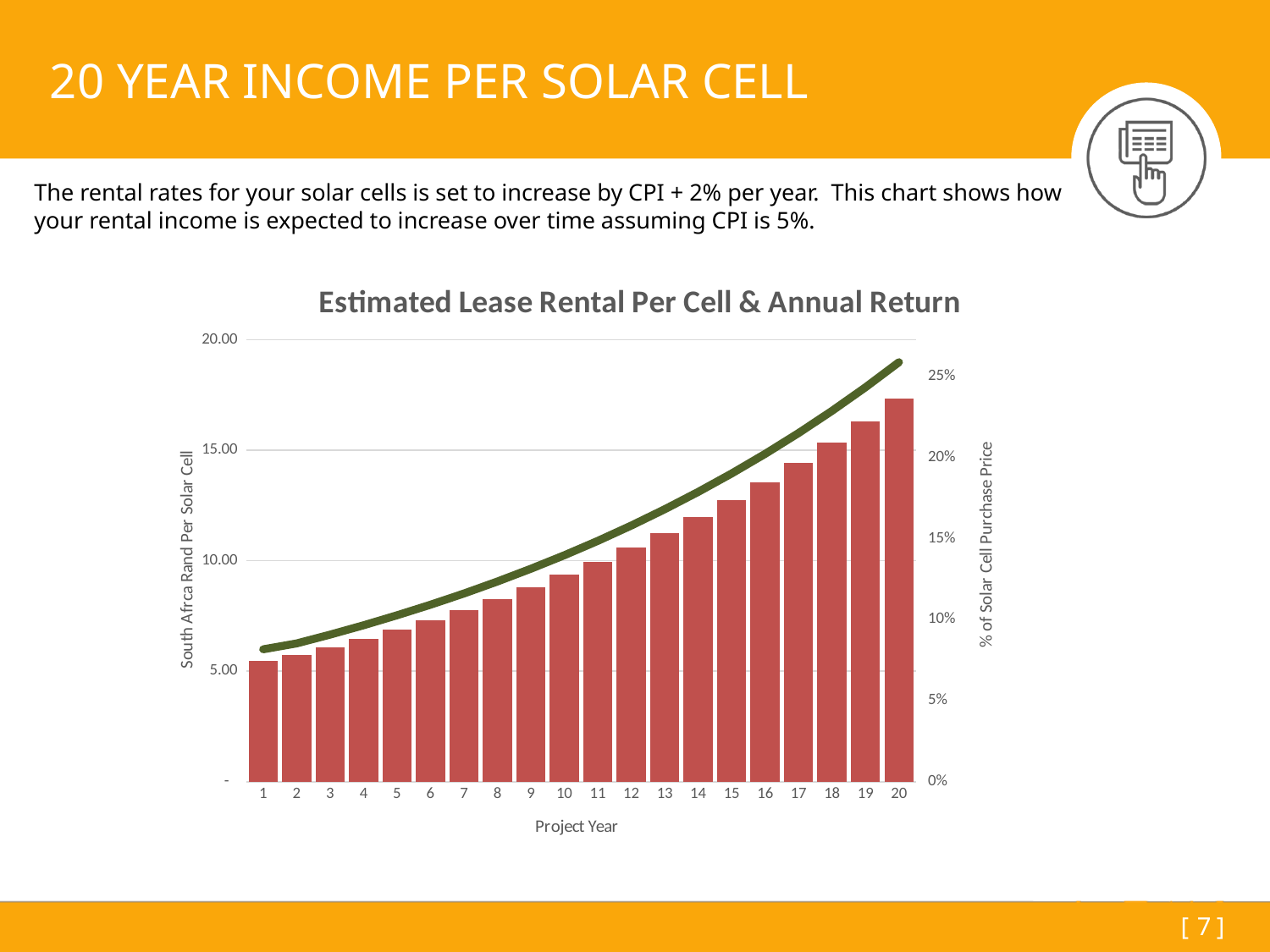
Which has the larger bar value, project year 5 or project year 15? Project year 15 Is the bar value for project year 19 greater or less than 15.00? greater What is the title of the chart? Estimated Lease Rental Per Cell & Annual Return Is the line value for project year 1 greater or less than 10%? less Which project year has the highest bar? 20 Do the bar values rise or fall as the project year increases? Rise Is the bar value for project year 17 greater or less than 15.00? less How many project years are plotted on the x axis? 20 What kind of chart is shown on the slide? A combined bar and line chart Which project year has the lowest bar? 1